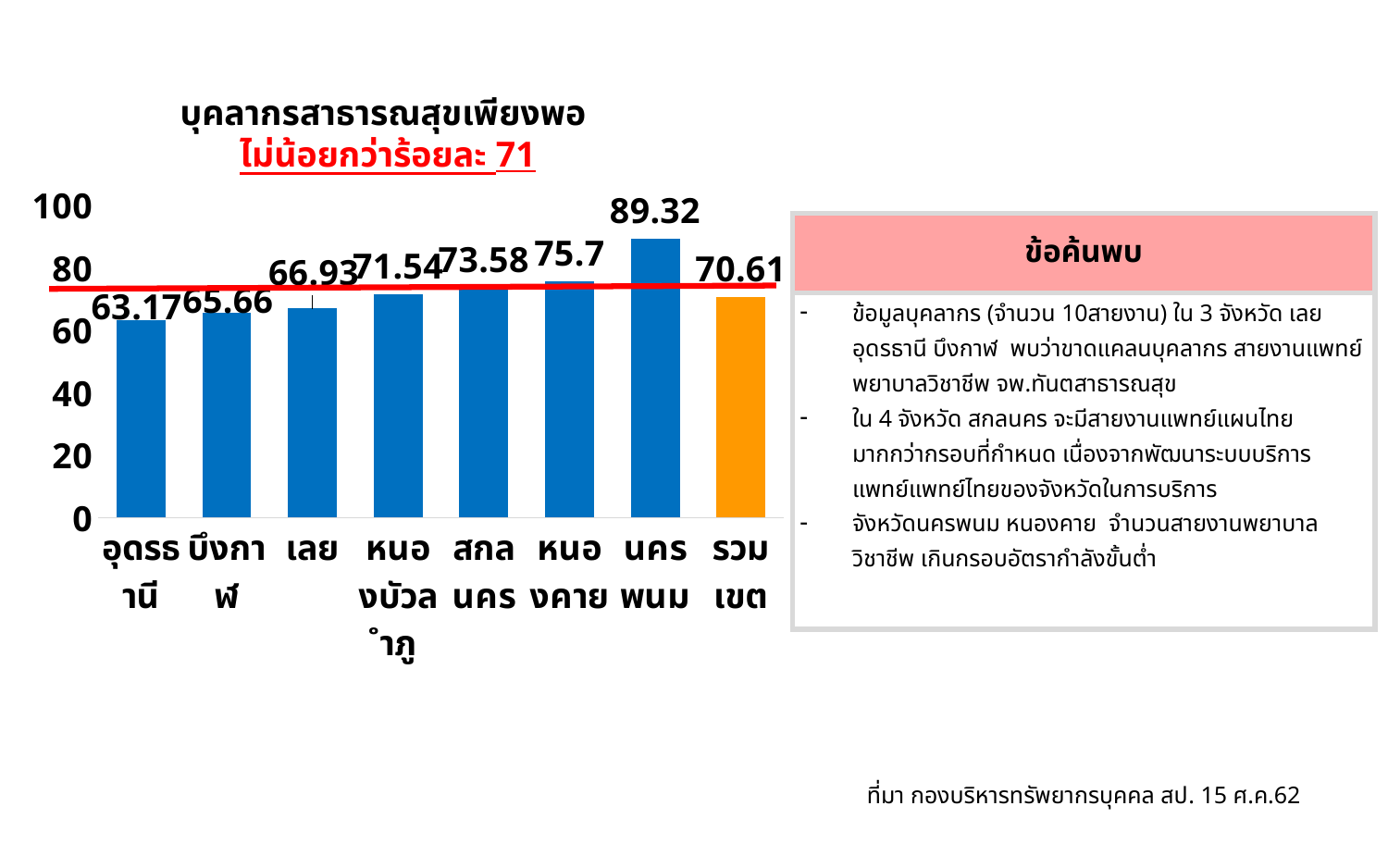
What is the value for รวมเขต? 70.61 Which bar is coloured orange instead of blue? รวมเขต Which category has the lowest value? อุดรธานี Which is larger, the value for หนองคาย or the value for เลย? หนองคาย What is the value for อุดรธานี? 63.17 How many bars are shown in the chart? 8 What is the value for สกลนคร? 73.58 What kind of chart is shown on the slide? bar chart Which province has the highest value? นครพนม Is the value for บึงกาฬ greater or less than 80? less What is the value for นครพนม? 89.32 What is the difference between the values for นครพนม and อุดรธานี? 26.15